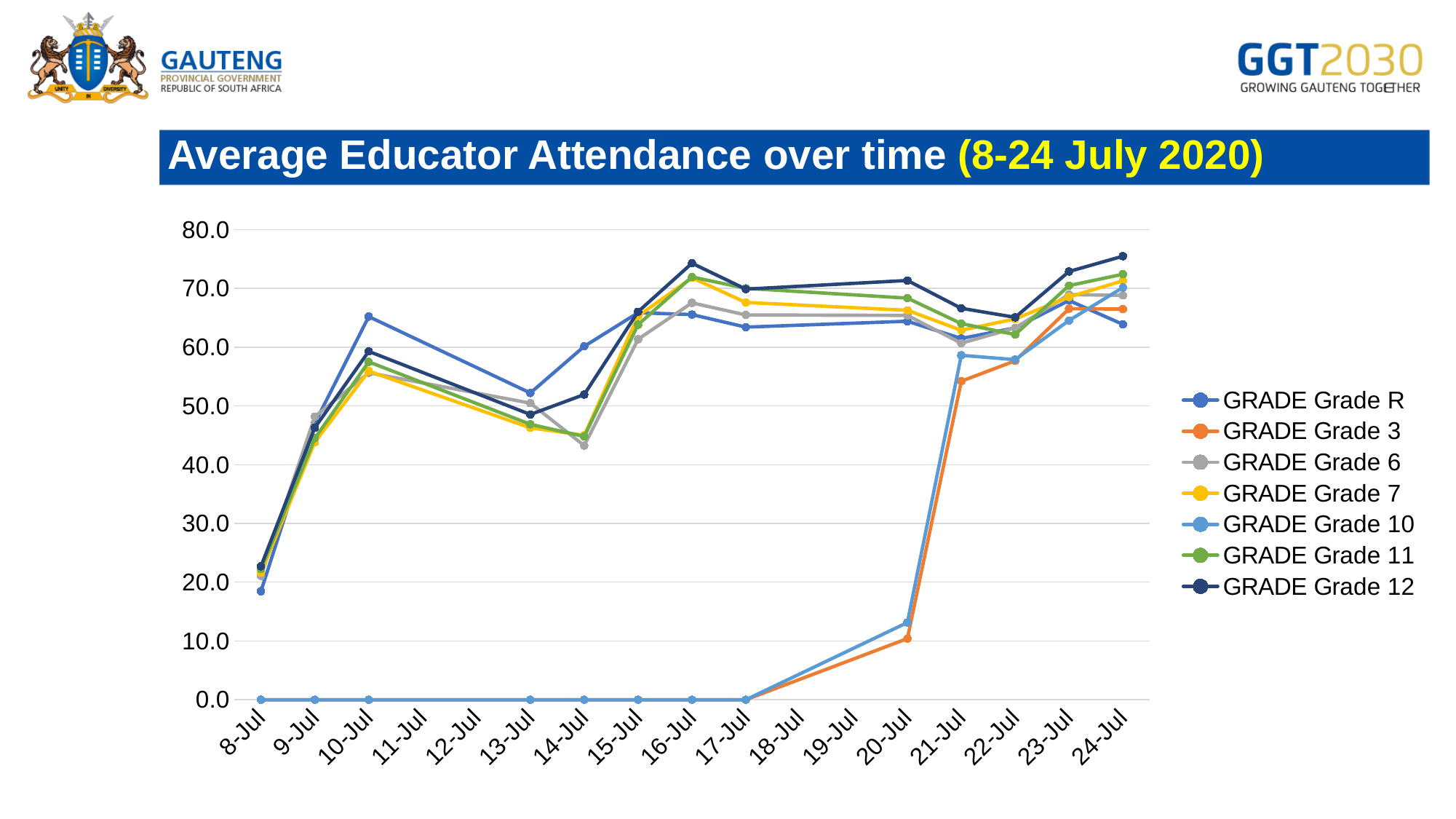
Is the value for GRADE Grade 6 on 14-Jul greater or less than 50.0? less How many dates are shown along the x axis? 17 Is the value for GRADE Grade 12 on 24-Jul greater or less than 70.0? greater What is the title of the chart on the slide? Average Educator Attendance over time (8-24 July 2020) Does the value for GRADE Grade R rise or fall from 10-Jul to 13-Jul? fall What is the value for GRADE Grade 10 on 15-Jul? 0.0 What kind of chart is shown on the slide? line chart What is the value for GRADE Grade 3 on 8-Jul? 0.0 Which series has the highest value on 24-Jul? GRADE Grade 12 On 16-Jul, which is larger: the value for GRADE Grade 12 or GRADE Grade R? GRADE Grade 12 How many series does the legend list? 7 Is the value for GRADE Grade R on 10-Jul greater or less than 60.0? greater